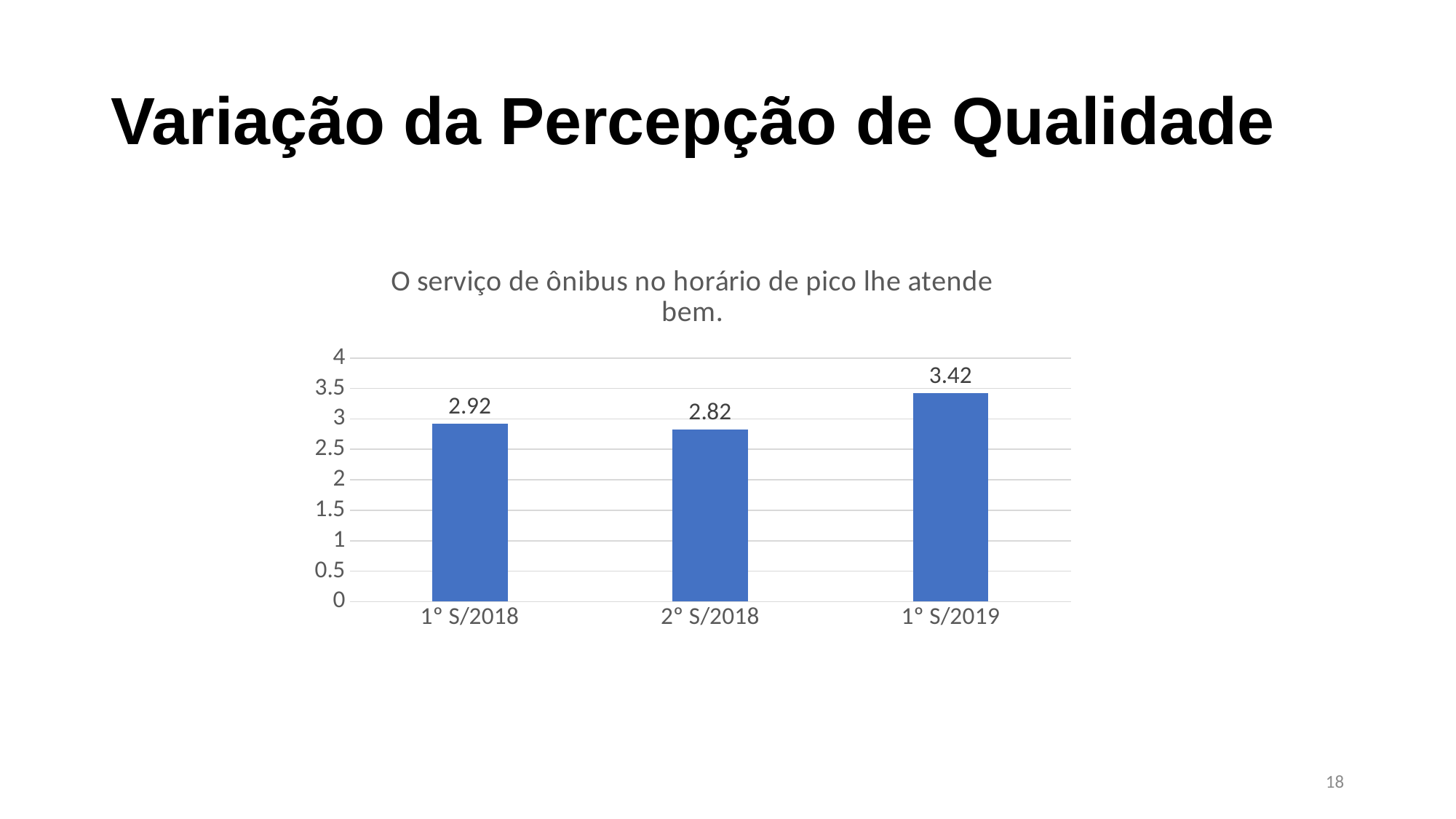
What is the value for 1º S/2019? 3.42 What is the value for 1º S/2018? 2.92 Is the value for 1º S/2019 greater or less than 3? greater What is the difference between the values for 1º S/2018 and 2º S/2018? 0.1 Which period has the lowest value? 2º S/2018 How many periods are shown on the x axis? 3 What is the value for 2º S/2018? 2.82 Which period has the highest value? 1º S/2019 Which is larger, the value for 1º S/2018 or the value for 1º S/2019? 1º S/2019 What kind of chart is shown on the slide? bar chart What is the title of the chart? O serviço de ônibus no horário de pico lhe atende bem. What is the difference between the values for 1º S/2019 and 2º S/2018? 0.6